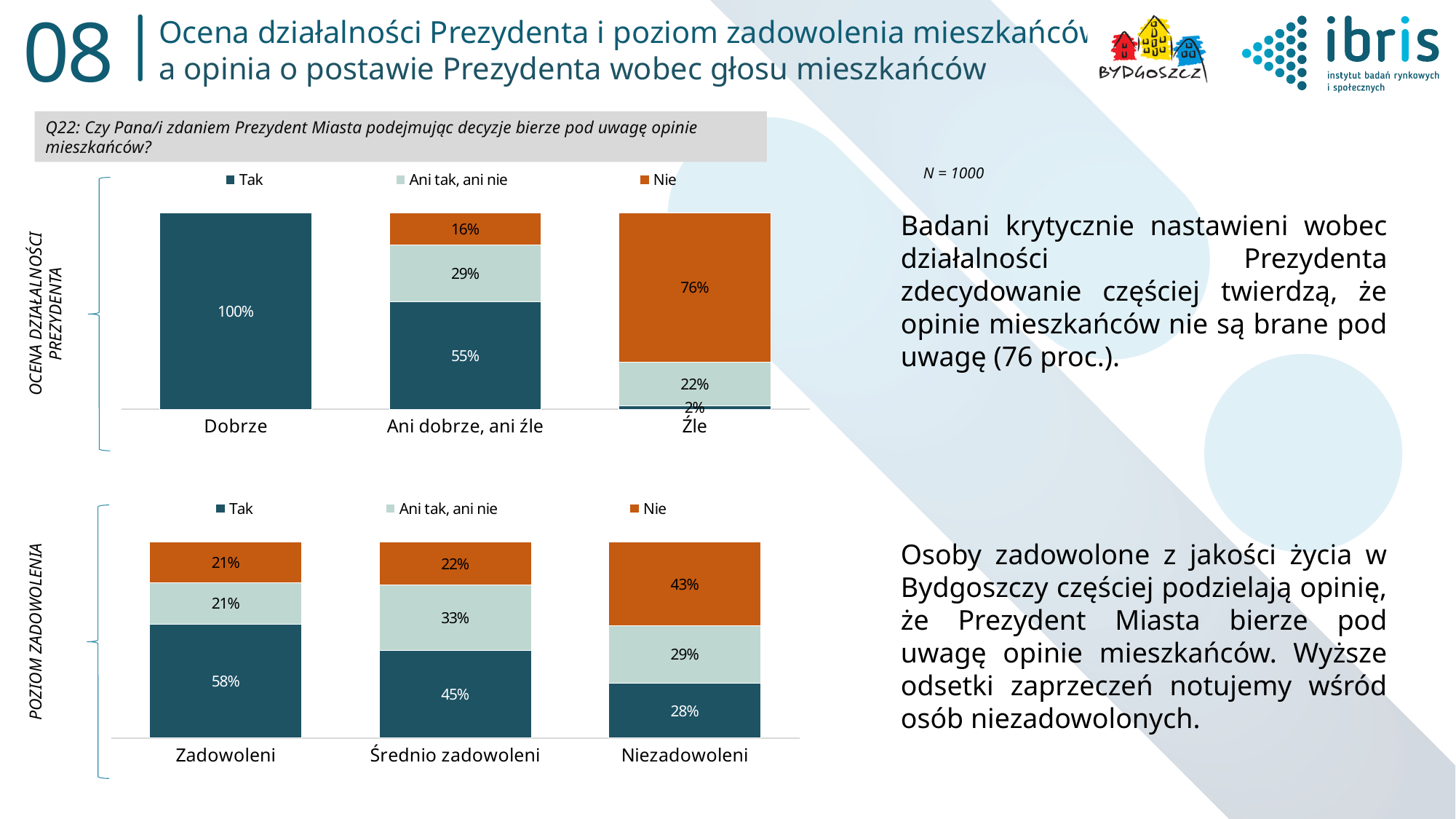
How many series does the legend of the bottom chart list? 3 In the bottom chart, which category has the lowest 'Tak' value? Niezadowoleni In the bottom chart, what is the 'Nie' value for 'Niezadowoleni'? 43% In the top chart (Ocena działalności Prezydenta), what is the 'Tak' value for 'Dobrze'? 100% In the bottom chart, what is the difference between the 'Tak' values for 'Zadowoleni' and 'Średnio zadowoleni'? 13% In the top chart, what is the difference between the 'Nie' values for 'Źle' and 'Ani dobrze, ani źle'? 60% In the top chart, what is the 'Ani tak, ani nie' value for 'Ani dobrze, ani źle'? 29% In the bottom chart (Poziom zadowolenia), what is the 'Tak' value for 'Zadowoleni'? 58% In the top chart, what is the 'Nie' value for 'Źle'? 76% What type of chart is the top chart? Stacked bar chart In the top chart, which category has the highest 'Tak' value? Dobrze In the bottom chart, which is larger: the 'Ani tak, ani nie' value for 'Średnio zadowoleni' or for 'Zadowoleni'? Średnio zadowoleni